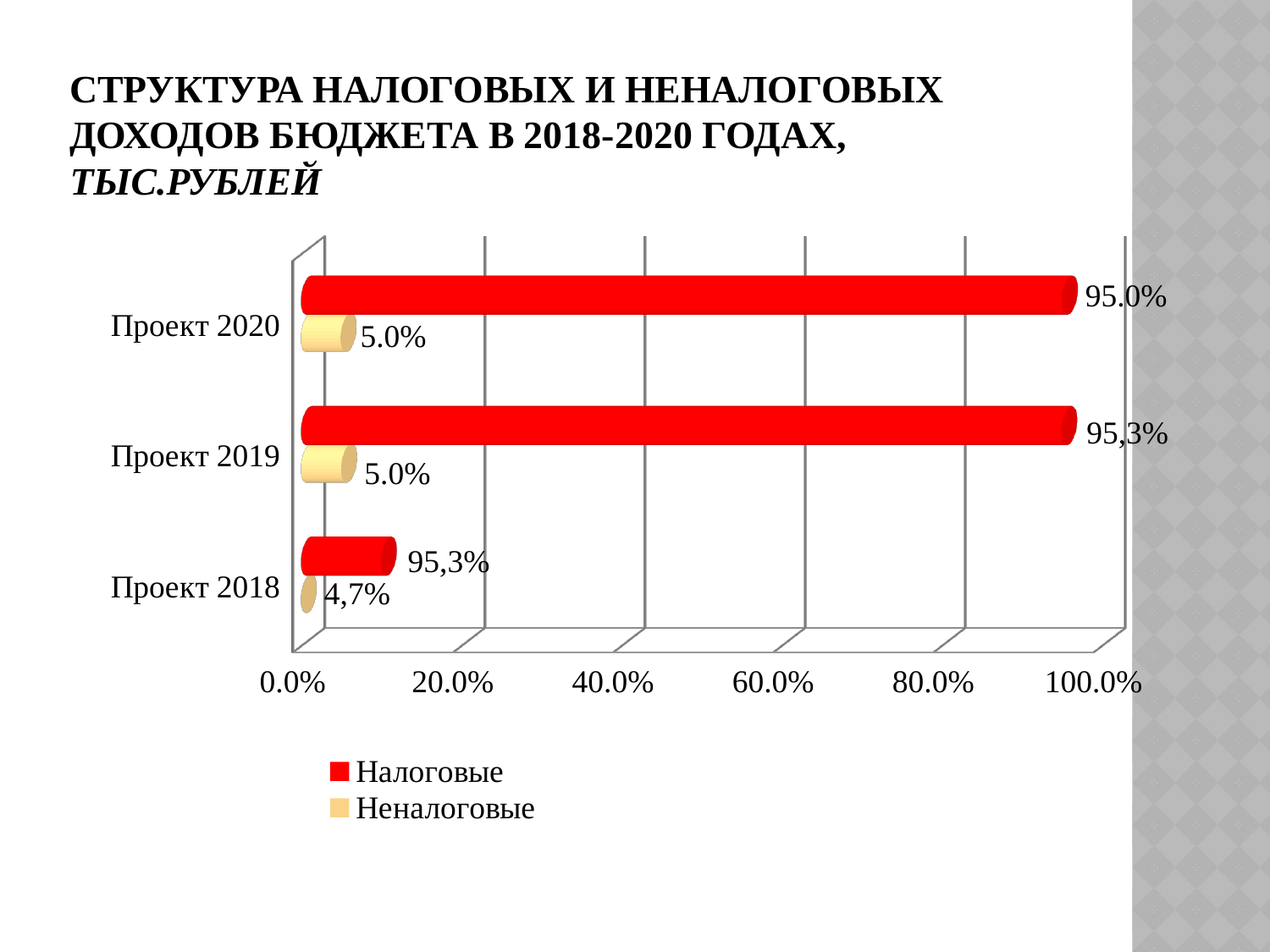
What is the value for Налоговые in Проект 2018? 95,3% What is the value for Неналоговые in Проект 2020? 5.0% What is the value for Неналоговые in Проект 2018? 4,7% What is the value for Налоговые in Проект 2020? 95.0% What is the value for Налоговые in Проект 2019? 95,3% Which series is shown in red in the legend? Налоговые How many categories are shown on the chart? 3 What is the difference between Налоговые and Неналоговые in Проект 2020? 90.0% How many series does the legend list? 2 Is the value for Налоговые in Проект 2020 greater or less than 80.0%? greater Which series is larger in Проект 2019, Налоговые or Неналоговые? Налоговые What type of chart is shown on the slide? bar chart